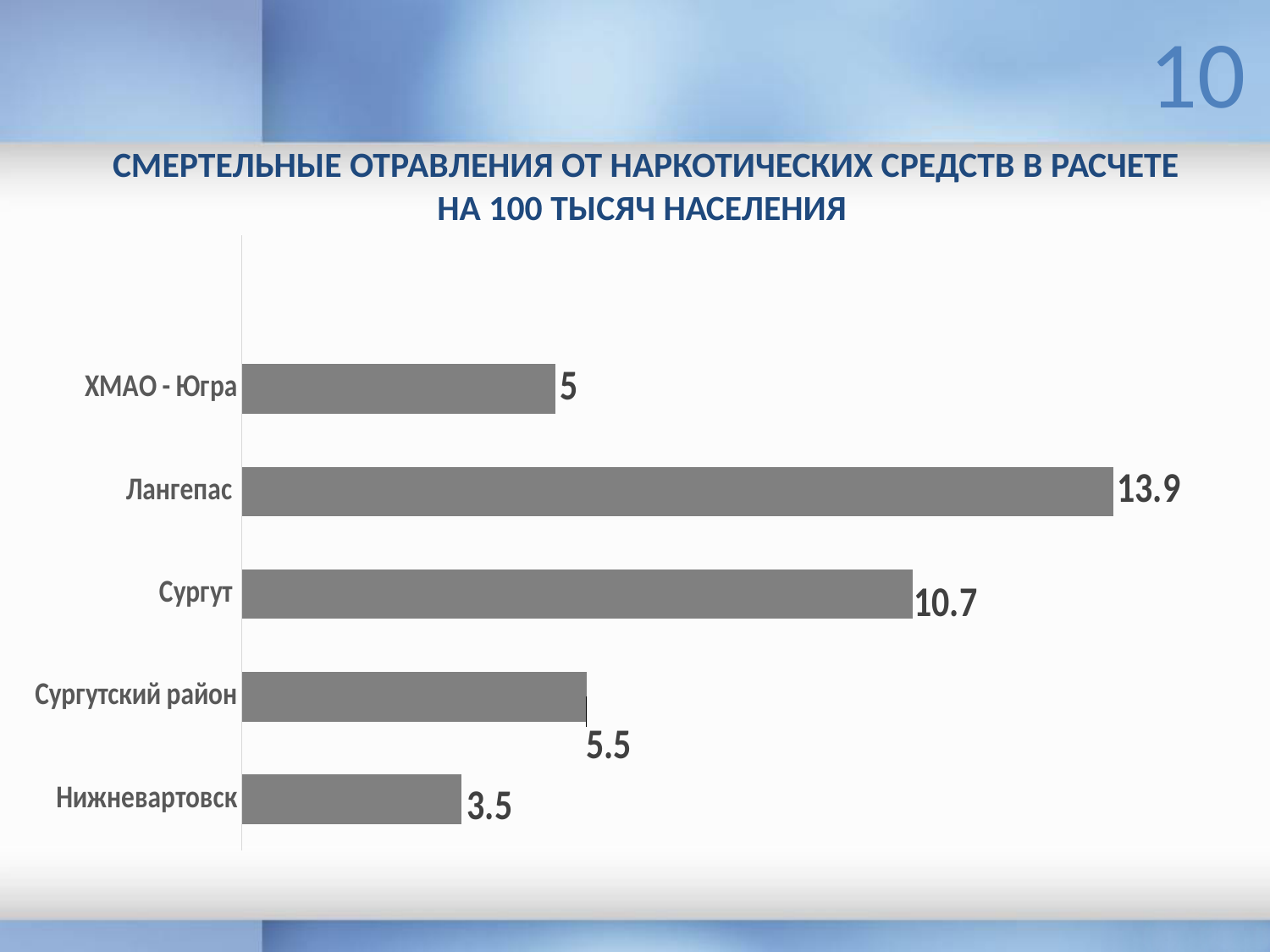
What is the value for Нижневартовск? 3.5 What is the title of the chart? СМЕРТЕЛЬНЫЕ ОТРАВЛЕНИЯ ОТ НАРКОТИЧЕСКИХ СРЕДСТВ В РАСЧЕТЕ НА 100 ТЫСЯЧ НАСЕЛЕНИЯ What is the value for Сургутский район? 5.5 Which category has the highest value? Лангепас What is the value for Сургут? 10.7 Which is larger, the value for Сургутский район or the value for ХМАО - Югра? Сургутский район What is the difference between the values for Лангепас and Сургут? 3.2 Which category has the lowest value? Нижневартовск What kind of chart is shown on the slide? bar chart How many categories are shown in the chart? 5 What is the value for Лангепас? 13.9 What is the value for ХМАО - Югра? 5